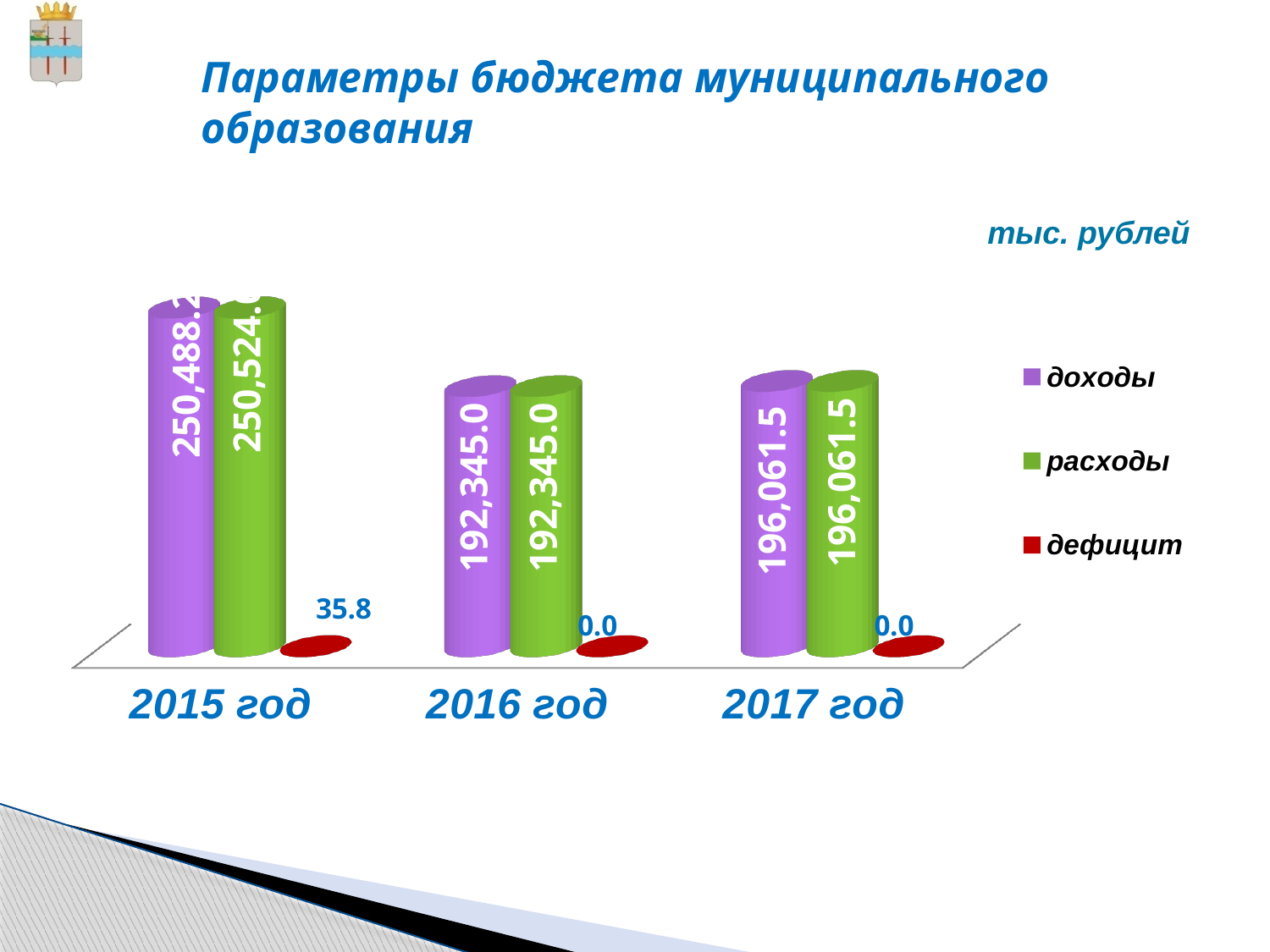
What is the difference between расходы for 2017 год and расходы for 2016 год? 3,716.5 What is the value of дефицит for 2016 год? 0.0 What is the value of доходы for 2016 год? 192,345.0 How many series does the legend list? 3 What unit of measurement is stated for the chart values? тыс. рублей How many years are shown on the x axis? 3 What is the value of дефицит for 2015 год? 35.8 What kind of chart is shown on the slide? bar chart Which year has the lowest расходы? 2016 год Which year has the highest доходы? 2015 год What is the value of расходы for 2017 год? 196,061.5 Which is larger, доходы for 2016 год or доходы for 2017 год? 2017 год